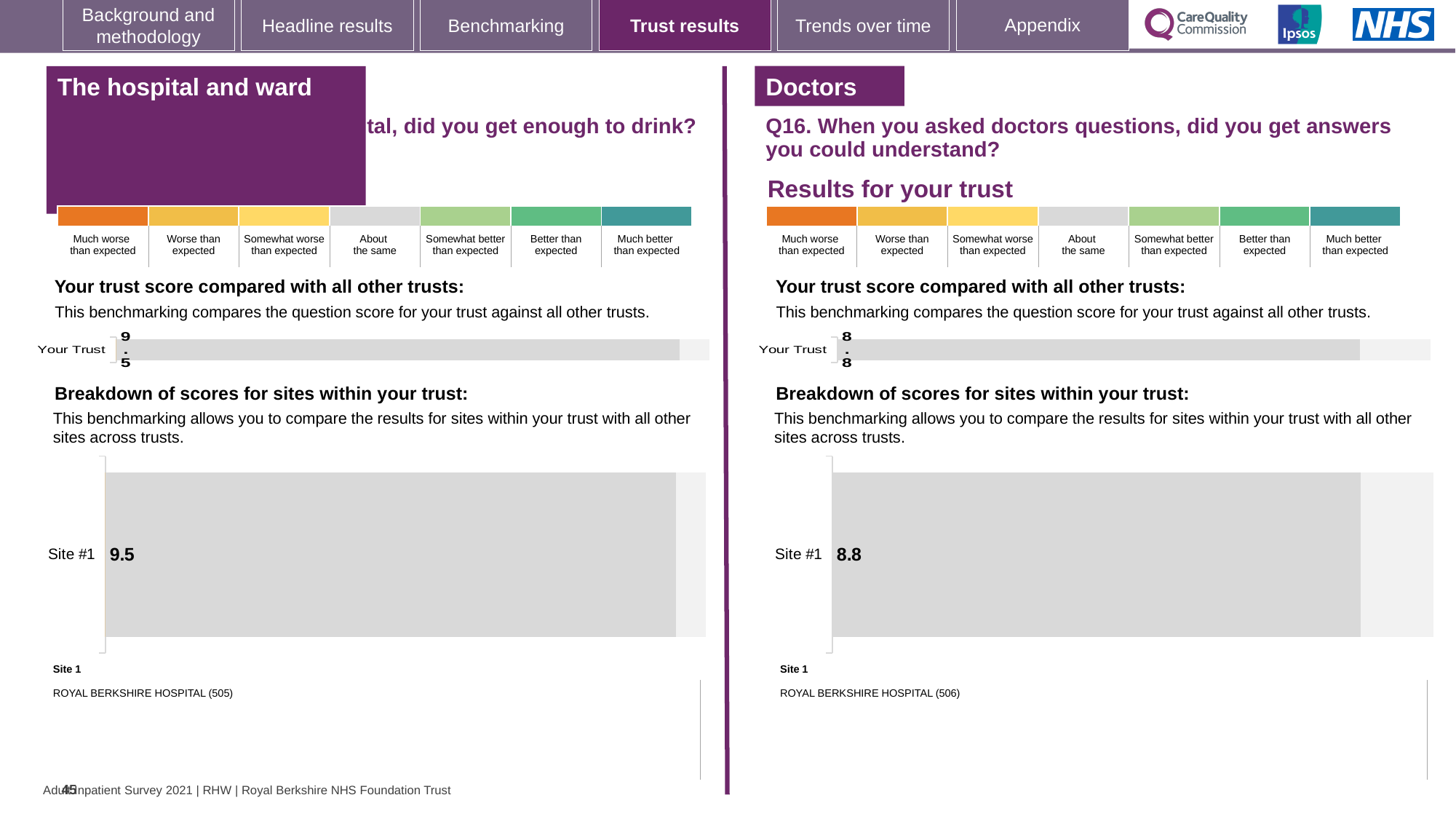
Which Site #1 score is higher: the one in the left-hand 'The hospital and ward' chart or the one in the Doctors (Q16) chart? The hospital and ward chart (9.5) In the left-hand 'The hospital and ward' section, what score is shown for Site #1 in the breakdown of scores chart? 9.5 In the Doctors (Q16) section, what is the 'Your Trust' score in the trust comparison chart? 8.8 In the Doctors (Q16) section, which hospital is listed as Site 1 below the breakdown chart? ROYAL BERKSHIRE HOSPITAL (506) How many bars are plotted in the 'Your Trust' chart in the left-hand 'The hospital and ward' section? 1 In the left-hand 'The hospital and ward' section, what number appears in brackets after ROYAL BERKSHIRE HOSPITAL for Site 1? 505 What is the difference between the Site #1 score in the left-hand chart (9.5) and the Site #1 score in the Doctors chart (8.8)? 0.7 In the left-hand 'The hospital and ward' section, what is the 'Your Trust' score in the trust comparison chart? 9.5 In the Doctors (Q16) section, what score is shown for Site #1 in the breakdown of scores chart? 8.8 How many sites are shown in the breakdown of scores chart in the Doctors (Q16) section? 1 What type of chart is used to show the Site #1 score in the Doctors (Q16) section? Bar chart